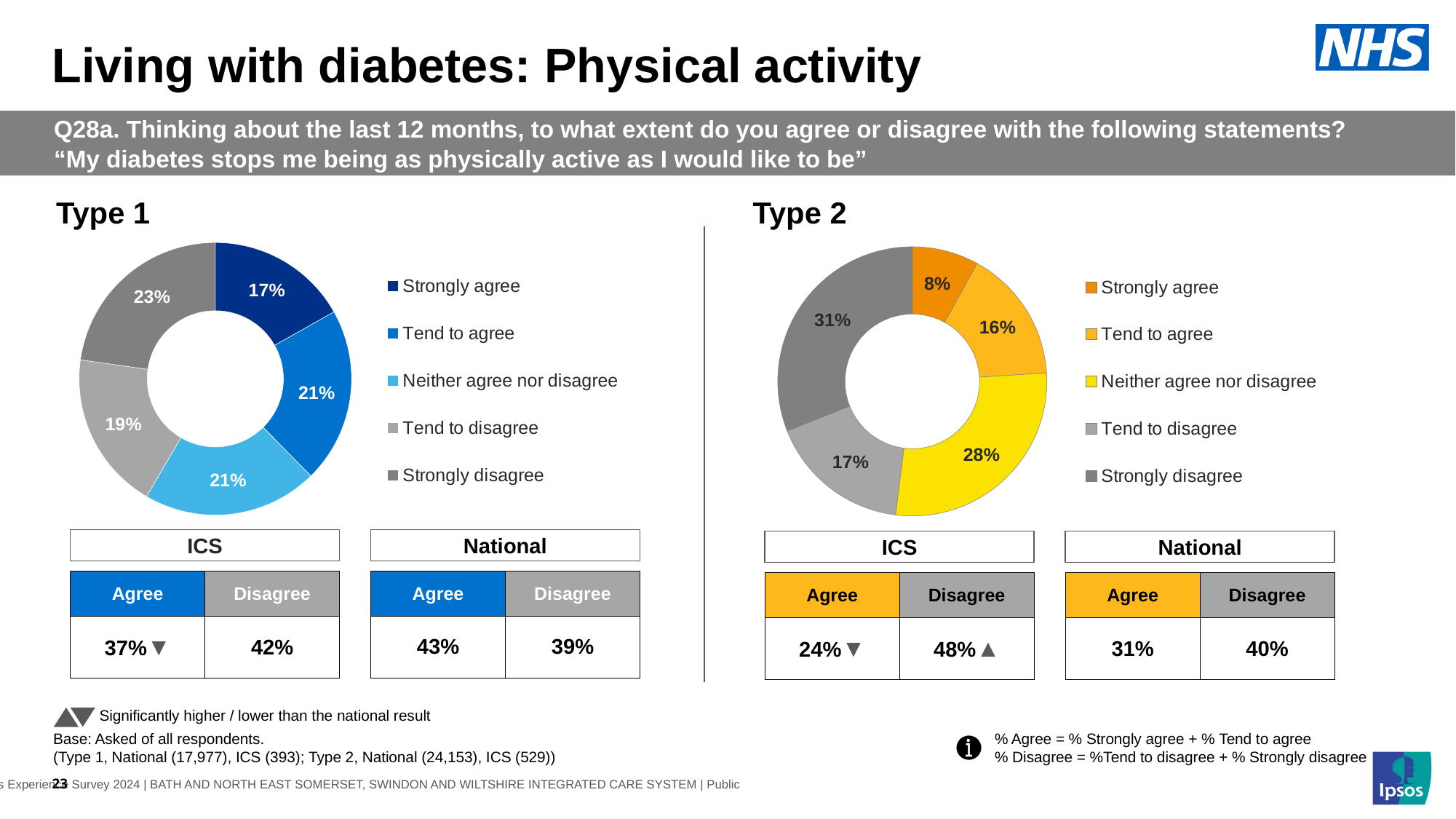
In the Type 2 chart, what colour represents 'Neither agree nor disagree'? Yellow In the Type 1 chart, what percentage of respondents said 'Strongly agree'? 17% In the Type 2 chart, what is the difference between the 'Strongly disagree' share and the 'Strongly agree' share? 23 percentage points In the Type 1 chart, which response category has the largest share? Strongly disagree In the Type 1 chart, what is the combined share of 'Tend to disagree' and 'Strongly disagree'? 42% How many entries does the legend of the Type 2 chart list? 5 How many response categories does the Type 1 chart show? 5 What kind of chart is used for the Type 1 data? Doughnut chart In the Type 1 chart, which is larger: the 'Strongly disagree' share or the 'Tend to disagree' share? Strongly disagree In the Type 2 chart, what percentage of respondents said 'Tend to agree'? 16% In the Type 2 chart, which response category has the smallest share? Strongly agree In the Type 2 chart, what percentage of respondents said 'Neither agree nor disagree'? 28%